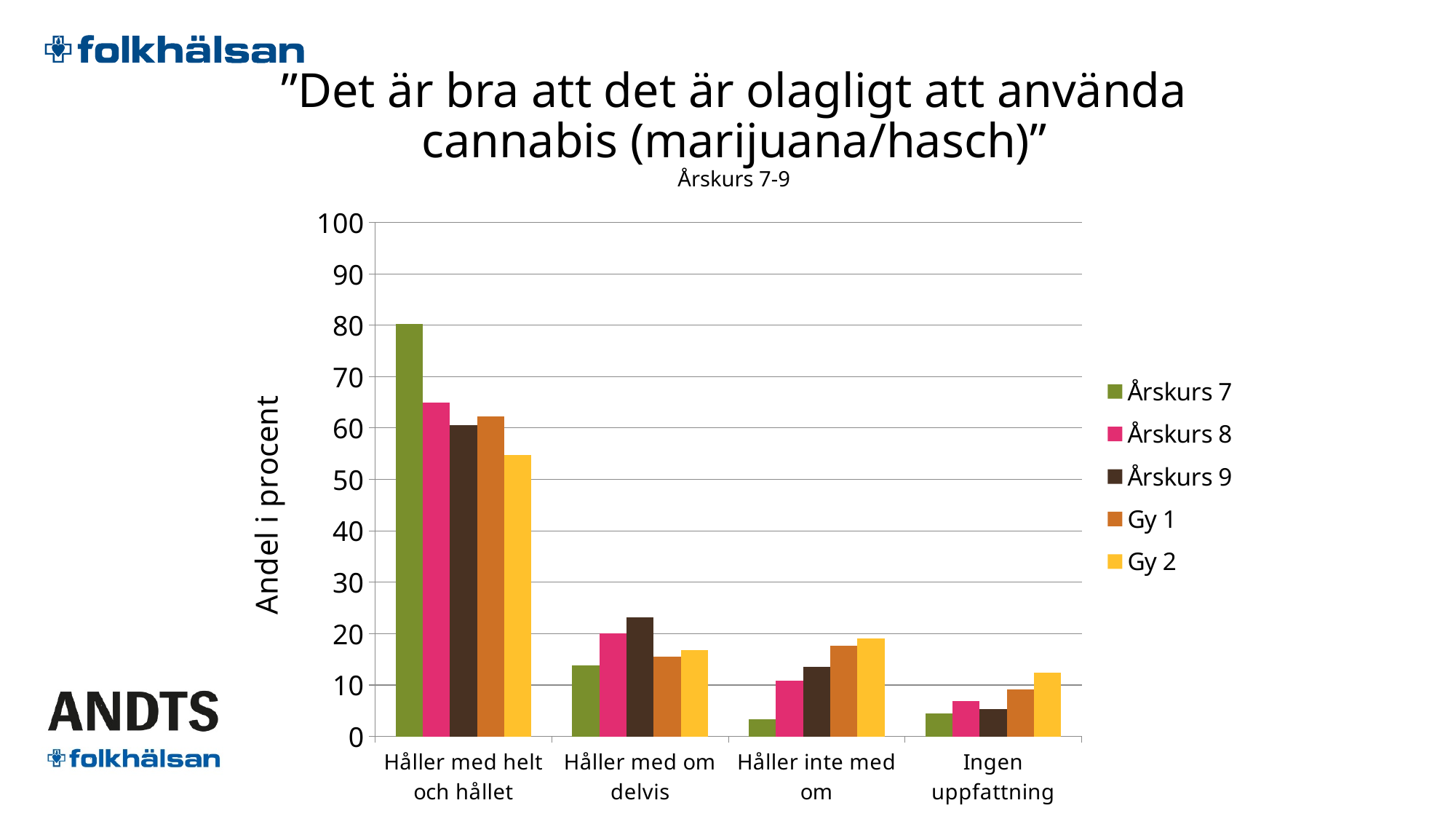
For "Håller med om delvis", which is larger: Årskurs 8 or Årskurs 9? Årskurs 9 Is the value for Gy 2 in "Håller med helt och hållet" greater or less than 60? less What kind of chart is shown on the slide? bar chart Which series has the lowest value for "Håller inte med om"? Årskurs 7 Which series has the lowest value for "Håller med helt och hållet"? Gy 2 Which series has the highest value for "Ingen uppfattning"? Gy 2 Is the value for Årskurs 7 in "Håller med helt och hållet" greater or less than 70? greater Is the value for Årskurs 7 in "Håller inte med om" greater or less than 10? less What is the title of the y axis? Andel i procent Which series has the highest value for "Håller med helt och hållet"? Årskurs 7 How many response categories are shown on the x axis? 4 How many series does the legend list? 5